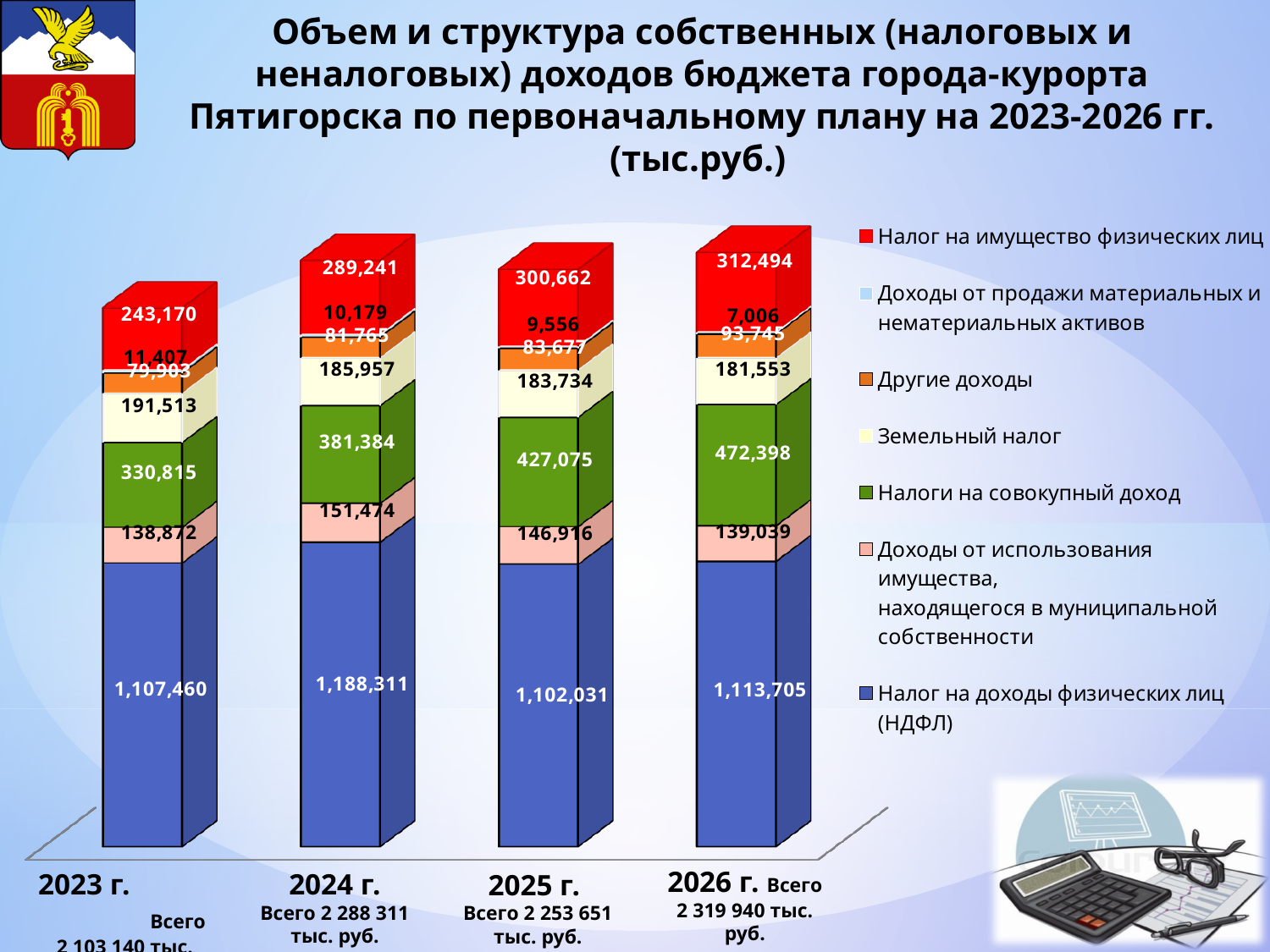
What is the value of Налоги на совокупный доход for 2026 г.? 472,398 In which year is Налог на доходы физических лиц (НДФЛ) the lowest? 2025 г. In which year is Налог на имущество физических лиц the highest? 2026 г. How many years (categories) are shown on the x axis of the chart? 4 What is the value of Доходы от продажи материальных и нематериальных активов for 2025 г.? 9,556 What is the difference between Налог на имущество физических лиц in 2026 г. and in 2023 г.? 69,324 What is the value of Земельный налог for 2023 г.? 191,513 How many series does the chart legend list? 7 What is the value of Налог на доходы физических лиц (НДФЛ) for 2024 г.? 1,188,311 What type of chart is shown on the slide? Stacked bar chart Do the values of Налоги на совокупный доход rise or fall from 2023 г. to 2026 г.? Rise Which is larger: Другие доходы in 2024 г. or Другие доходы in 2026 г.? 2026 г.